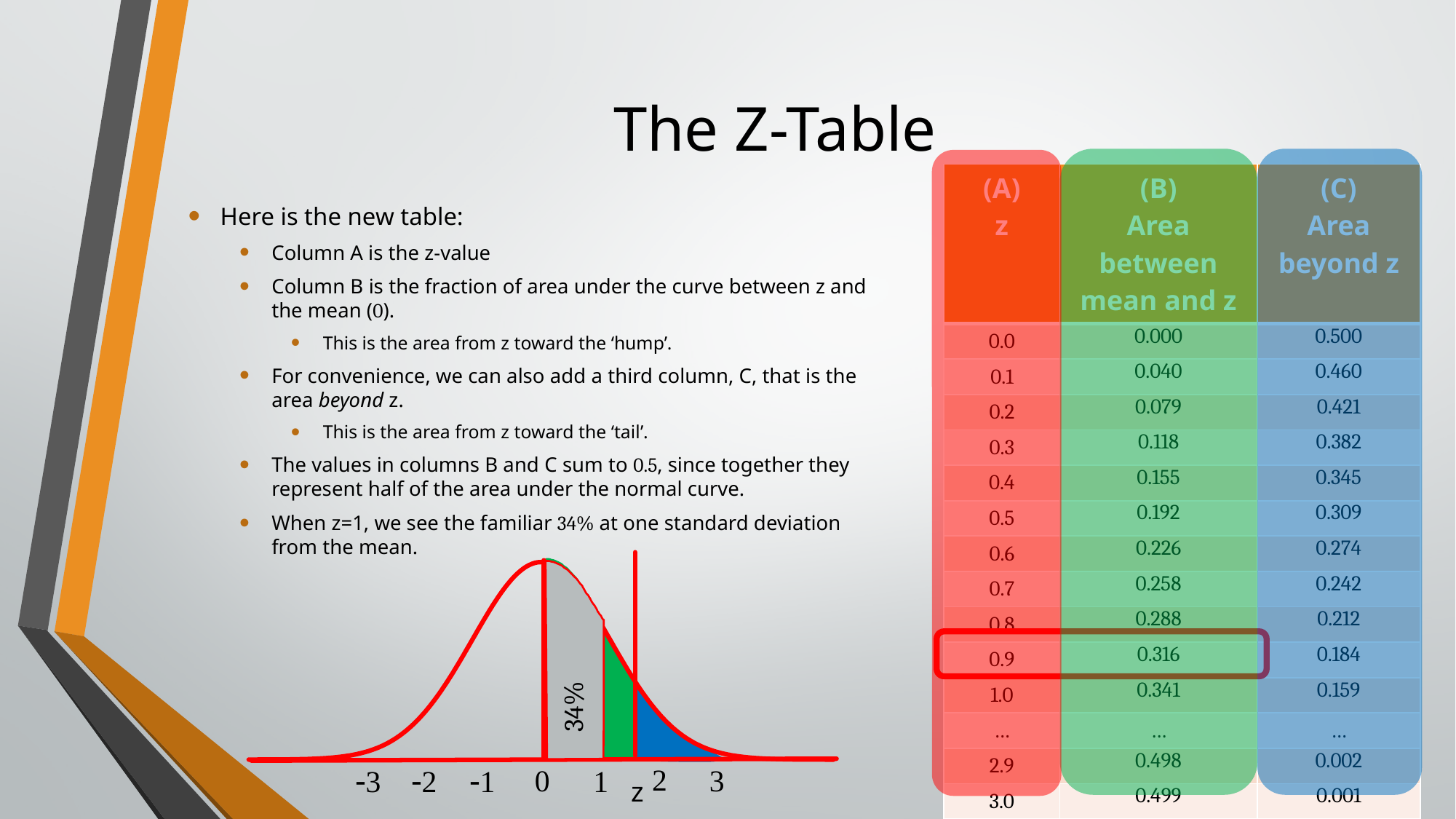
At which x-axis value does the curve chart reach its peak? 0 How many tick labels are shown on the x axis of the curve chart? 7 In the Z-table on the right, which z row is outlined with a red box? 0.9 In the Z-table on the right, what is the value in column (B) Area between mean and z for z = 1.0? 0.341 What letter labels the x axis of the curve chart? z In the Z-table on the right, what is the value in column (C) Area beyond z for z = 0.9? 0.184 In the curve chart, does the curve rise or fall as x goes from 0 to 3? fall In the curve chart, what percentage label is printed in the shaded region between 0 and 1? 34% What kind of chart is shown at the bottom left of the slide? line chart In the curve chart, what colour is the shaded region between 0 and 1? grey In the Z-table on the right, what is the value in column (C) Area beyond z for z = 0.0? 0.500 In the curve chart, does the curve rise or fall as x goes from -3 to 0? rise